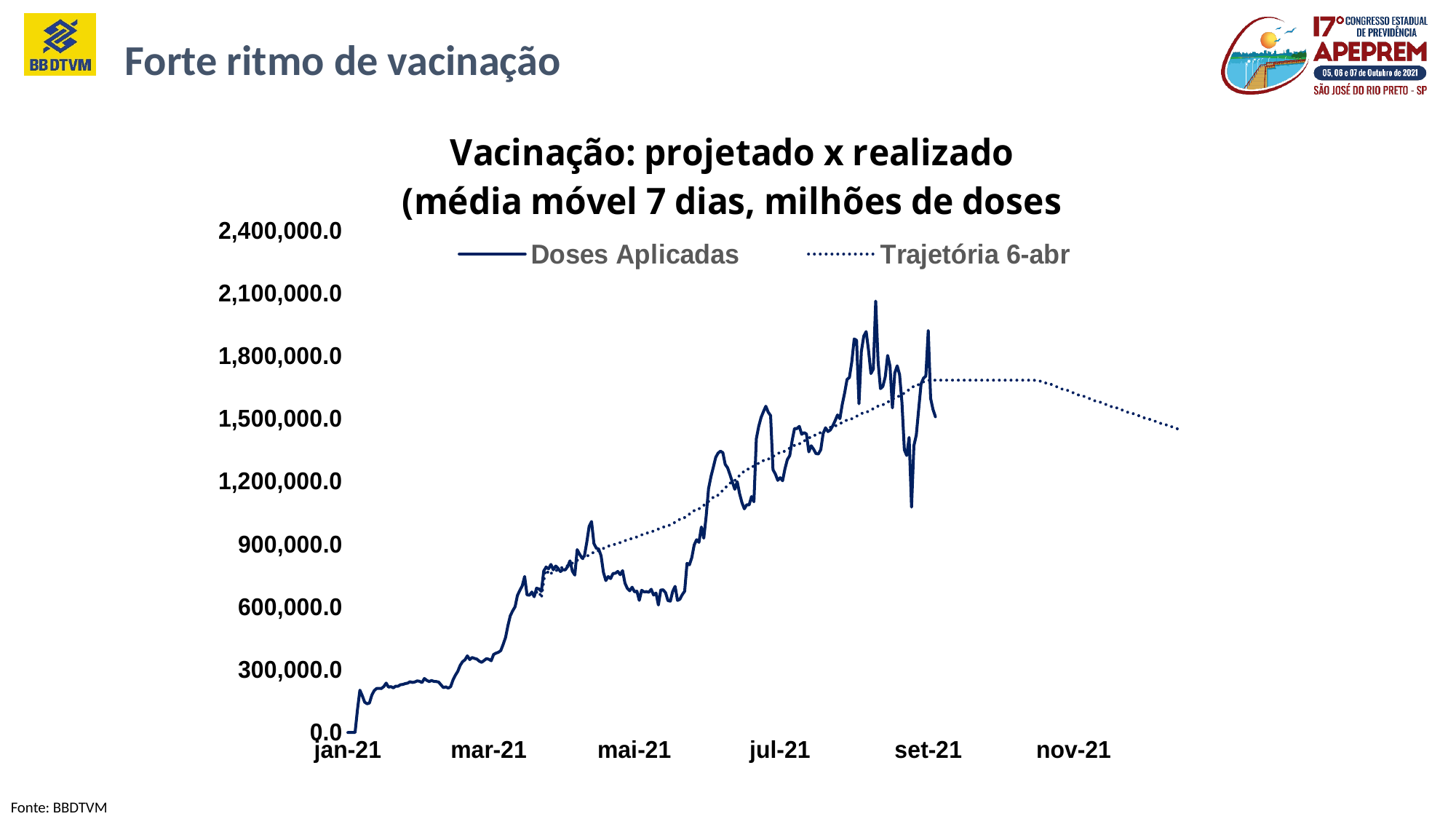
How many series does the chart legend list? 2 What kind of chart is shown on the slide? line chart Which series is drawn with a dotted line? Trajetória 6-abr Does the Doses Aplicadas line generally rise or fall from jan-21 to set-21? rise Is the peak value of Doses Aplicadas greater or less than 1,800,000.0? greater Does the Trajetória 6-abr line rise or fall after nov-21? fall Which series extends further to the right on the x axis, Doses Aplicadas or Trajetória 6-abr? Trajetória 6-abr What is the highest value shown on the y axis? 2,400,000.0 What are the two series named in the chart legend? Doses Aplicadas and Trajetória 6-abr How many month labels are shown on the x axis? 6 Is the value of Trajetória 6-abr at nov-21 greater or less than 1,500,000.0? greater